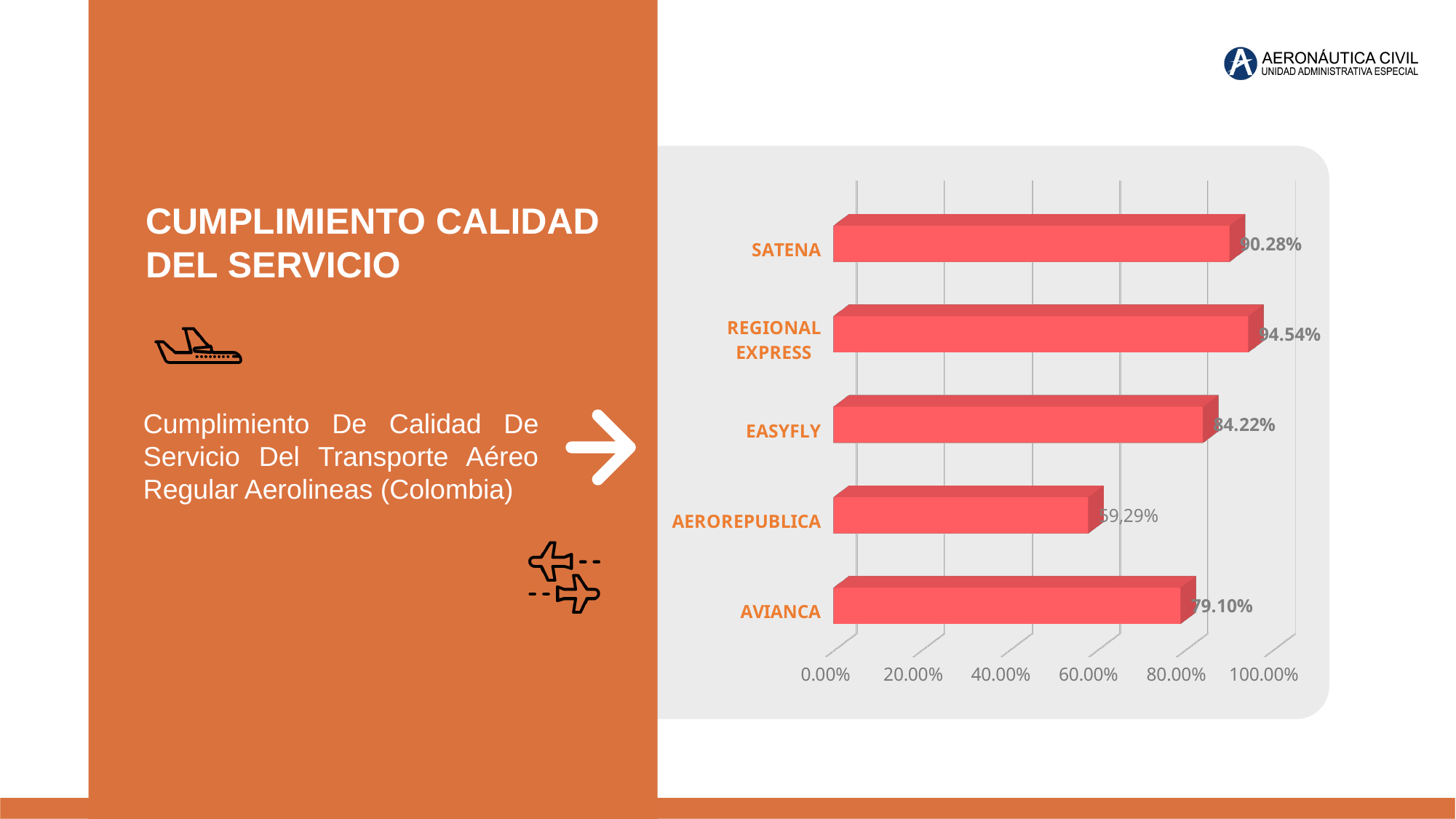
What is the difference between the values for REGIONAL EXPRESS and SATENA? 4.26% What is the difference between the values for EASYFLY and AVIANCA? 5.12% What is the value for SATENA? 90.28% Which airline has the highest value? REGIONAL EXPRESS How many airlines are shown in the chart? 5 Is the value for AEROREPUBLICA greater or less than 60.00%? less What is the value for REGIONAL EXPRESS? 94.54% Which airline has the lowest value? AEROREPUBLICA What is the value for AVIANCA? 79.10% What is the value for EASYFLY? 84.22% Which is larger, the value for SATENA or the value for EASYFLY? SATENA What kind of chart is shown on the slide? bar chart